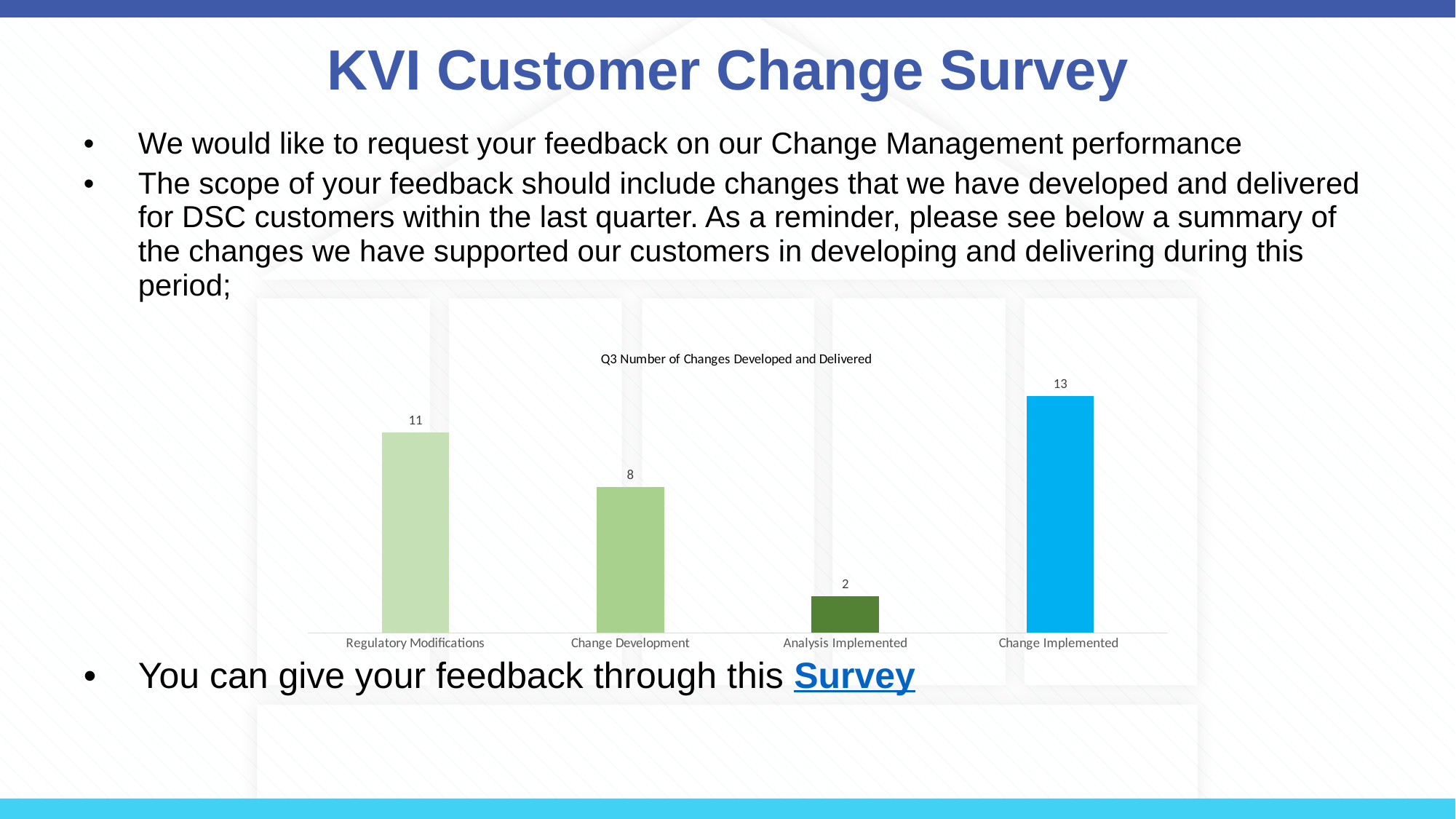
What is the title of the chart? Q3 Number of Changes Developed and Delivered What is the difference between the values for Change Development and Analysis Implemented? 6 What is the value for Analysis Implemented? 2 How many categories are shown in the chart? 4 What is the value for Change Implemented? 13 What is the difference between the values for Change Implemented and Regulatory Modifications? 2 Which category has the highest value? Change Implemented What is the value for Change Development? 8 Which category has the lowest value? Analysis Implemented What kind of chart is shown on the slide? Bar chart Which is larger, the value for Regulatory Modifications or the value for Change Development? Regulatory Modifications What is the value for Regulatory Modifications? 11